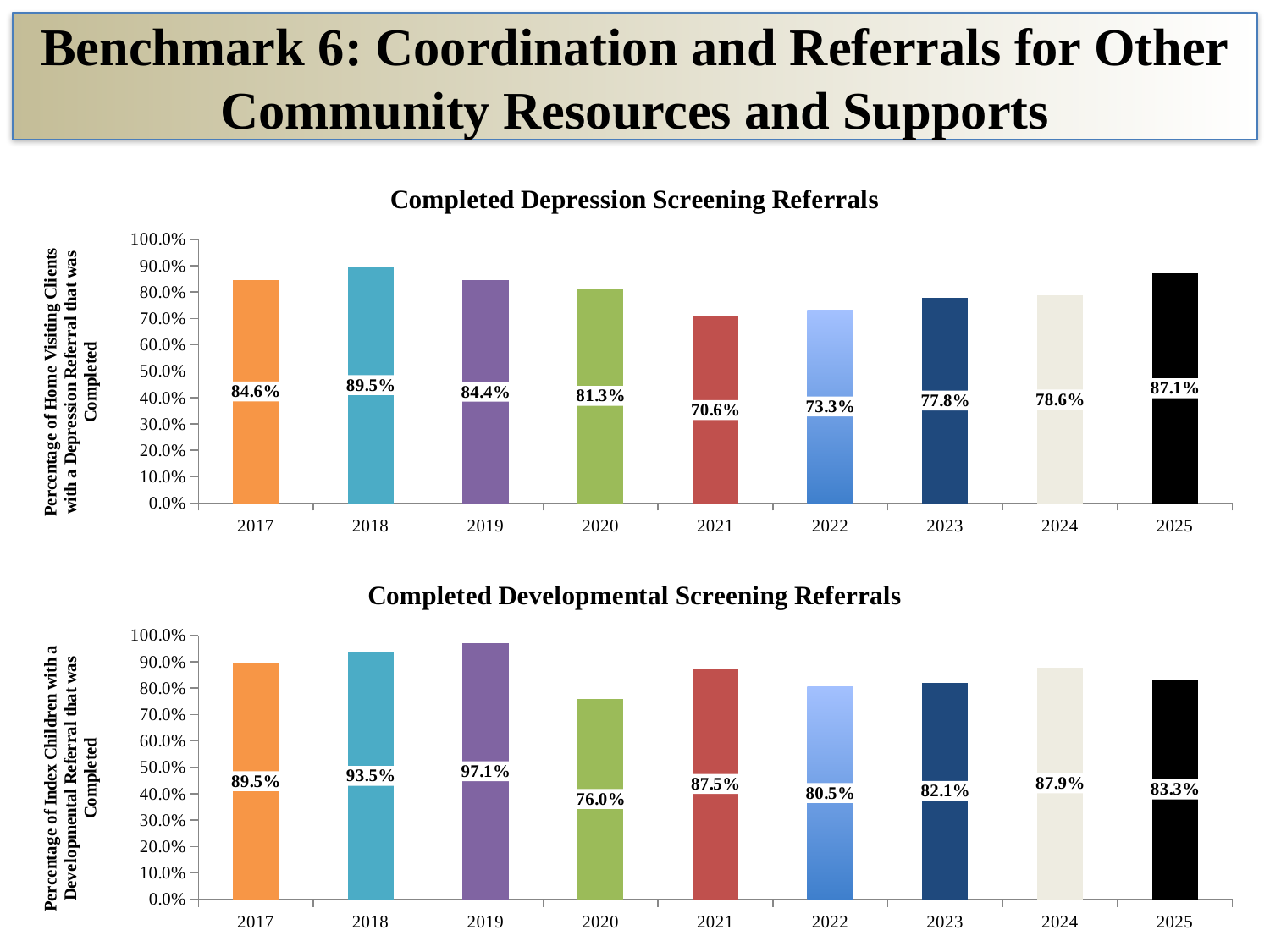
What kind of chart is the Completed Depression Screening Referrals chart? bar chart In the Completed Depression Screening Referrals chart, what is the value for 2021? 70.6% In the Completed Depression Screening Referrals chart, is the value for 2022 greater or less than 80.0%? less In the Completed Developmental Screening Referrals chart, which is larger, the value for 2021 or the value for 2025? 2021 In the Completed Depression Screening Referrals chart, which year has the highest value? 2018 How many years are shown on the x axis of the Completed Developmental Screening Referrals chart? 9 In the Completed Depression Screening Referrals chart, do the values rise or fall from 2021 to 2025? rise In the Completed Developmental Screening Referrals chart, what is the value for 2019? 97.1% What is the y-axis label of the Completed Depression Screening Referrals chart? Percentage of Home Visiting Clients with a Depression Referral that was Completed In the Completed Developmental Screening Referrals chart, which year has the lowest value? 2020 In the Completed Depression Screening Referrals chart, what is the difference between the 2025 value and the 2024 value? 8.5% In the Completed Developmental Screening Referrals chart, what is the difference between the 2018 value and the 2020 value? 17.5%